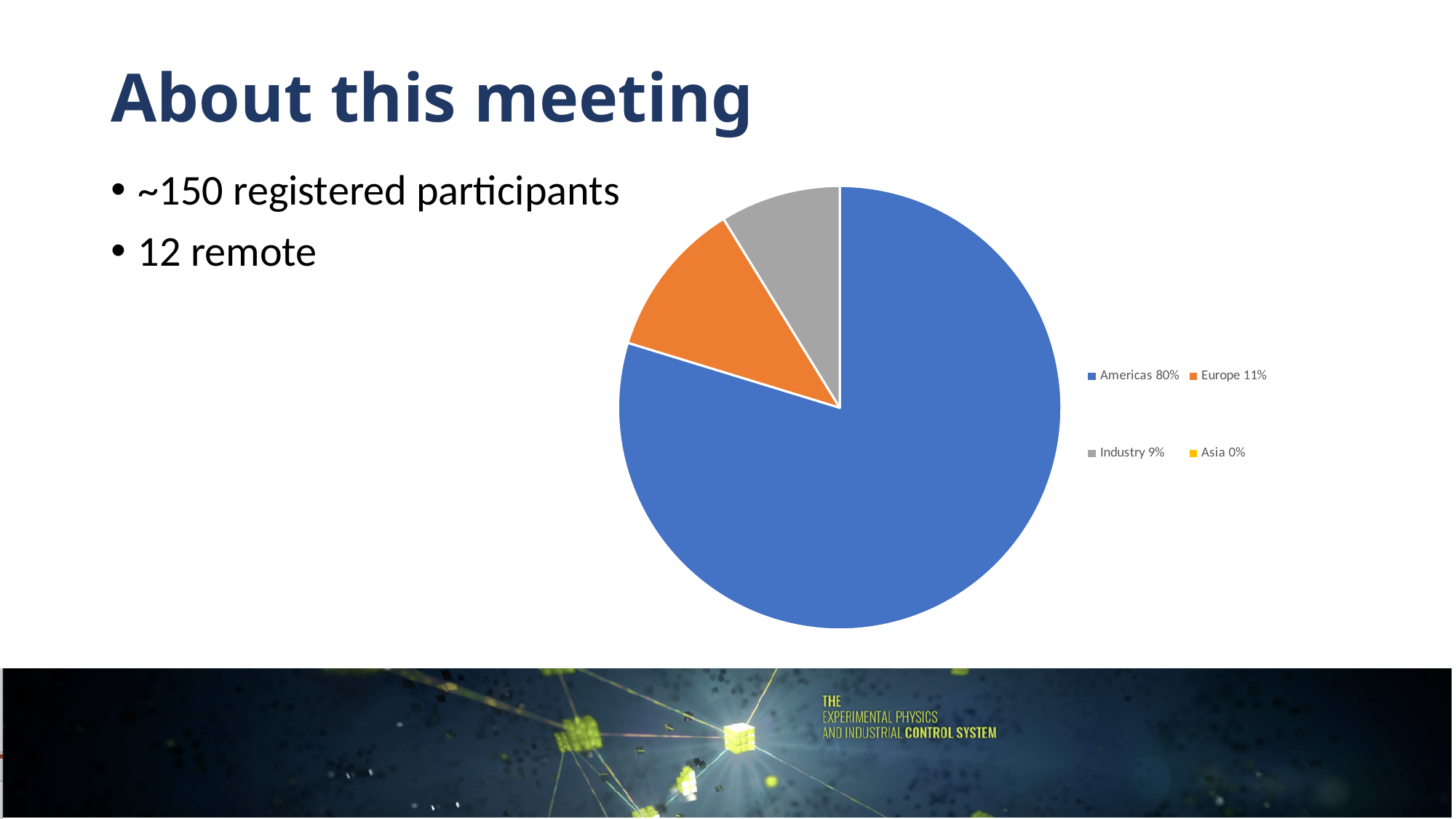
Which is larger, the Europe share or the Industry share? Europe Which category has the smallest share in the legend? Asia What share of the pie does Asia represent? 0% What share of the pie does Industry represent? 9% What share of the pie does Americas represent? 80% What is the difference in percentage points between the Americas share and the Europe share? 69 What colour is the Americas slice? blue What kind of chart is shown on the slide? pie chart How many categories does the legend list? 4 Which category has the largest slice of the pie? Americas What colour is the Europe slice? orange